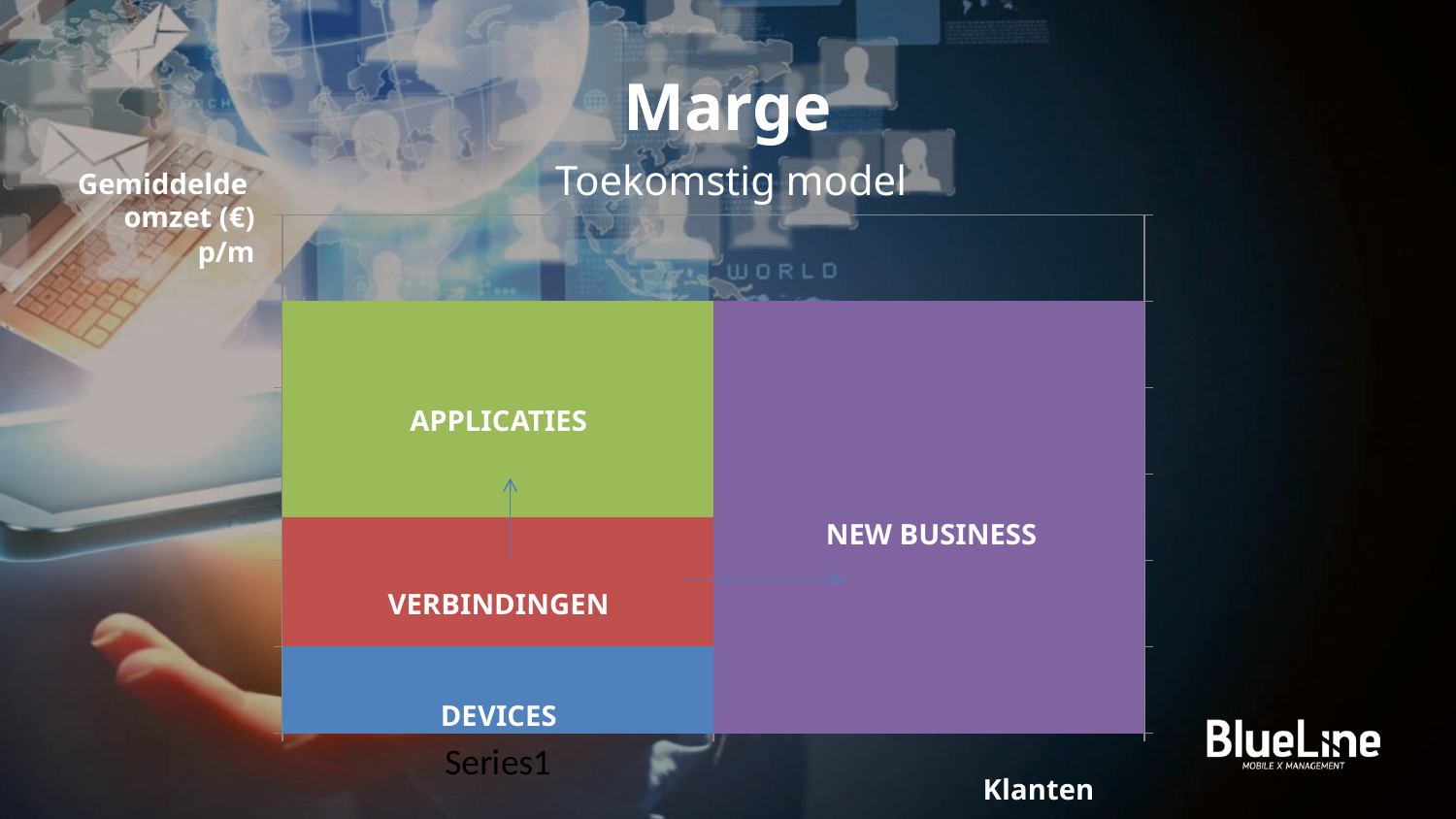
Which segment is larger in the Series1 bar, VERBINDINGEN or DEVICES? VERBINDINGEN Which segment of the Series1 stacked bar is the largest? APPLICATIES How many labelled segments are there in the chart in total? 4 Which segment of the Series1 stacked bar is the smallest? DEVICES Which segment is taller, NEW BUSINESS or APPLICATIES? NEW BUSINESS What is the label on the vertical axis of the chart? Gemiddelde omzet (€) p/m How many segments make up the stacked bar labelled Series1? 3 What kind of chart is shown on the slide? Stacked bar chart Which segment is larger in the Series1 bar, APPLICATIES or VERBINDINGEN? APPLICATIES